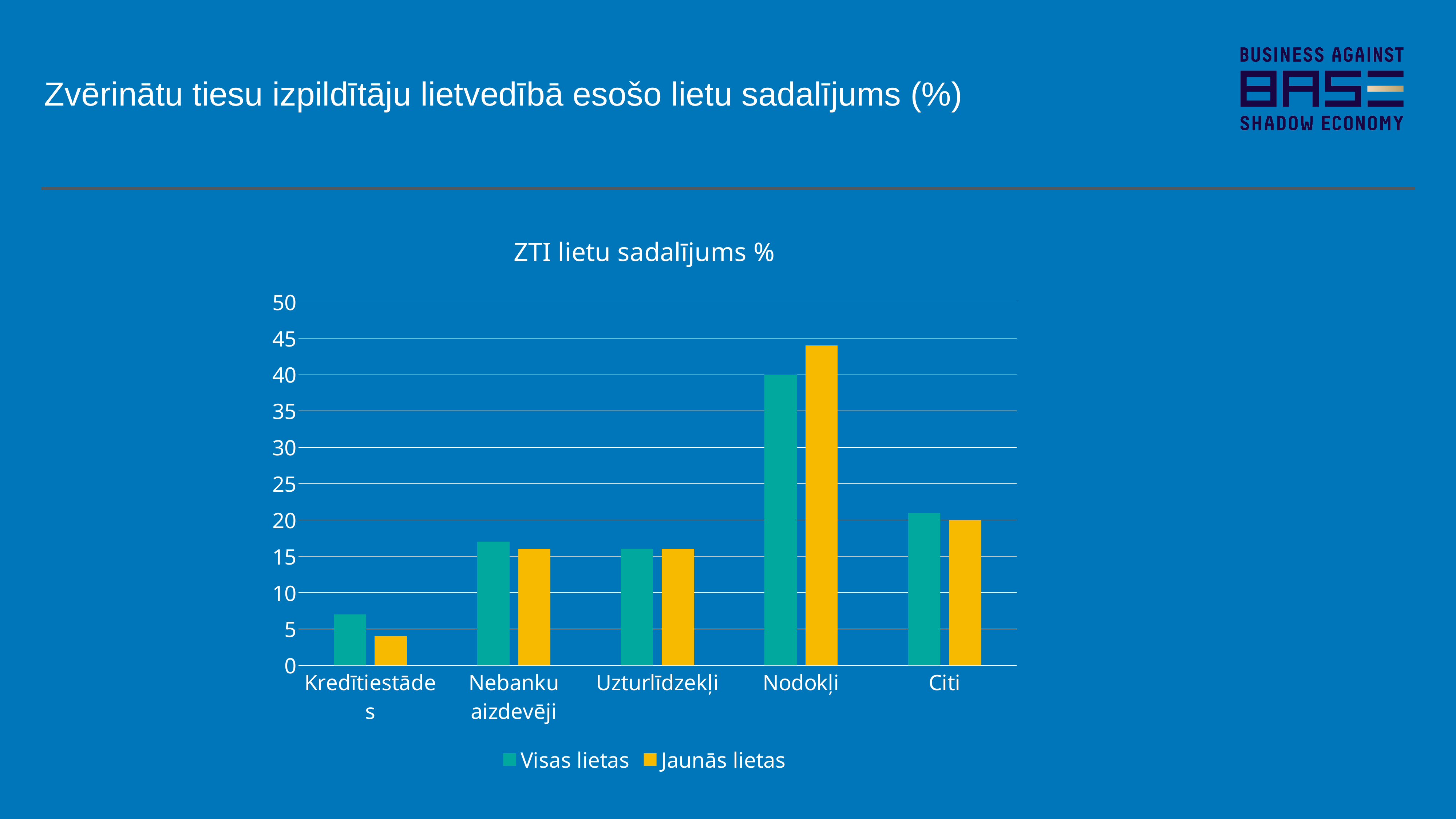
Is the value for Jaunās lietas in Nodokļi greater or less than 40? greater Is the value for Jaunās lietas in Kredītiestādes greater or less than 5? less Which category has the highest value for Visas lietas? Nodokļi What kind of chart is shown on the slide? bar chart Which category has the lowest value for Jaunās lietas? Kredītiestādes Is the value for Visas lietas in Nebanku aizdevēji greater or less than 15? greater How many categories are shown on the x axis of the chart? 5 For Nodokļi, which series has the larger value, Visas lietas or Jaunās lietas? Jaunās lietas Which series is shown in orange in the chart? Jaunās lietas For Kredītiestādes, which series has the larger value, Visas lietas or Jaunās lietas? Visas lietas What is the title of the chart? ZTI lietu sadalījums % How many series does the chart's legend list? 2